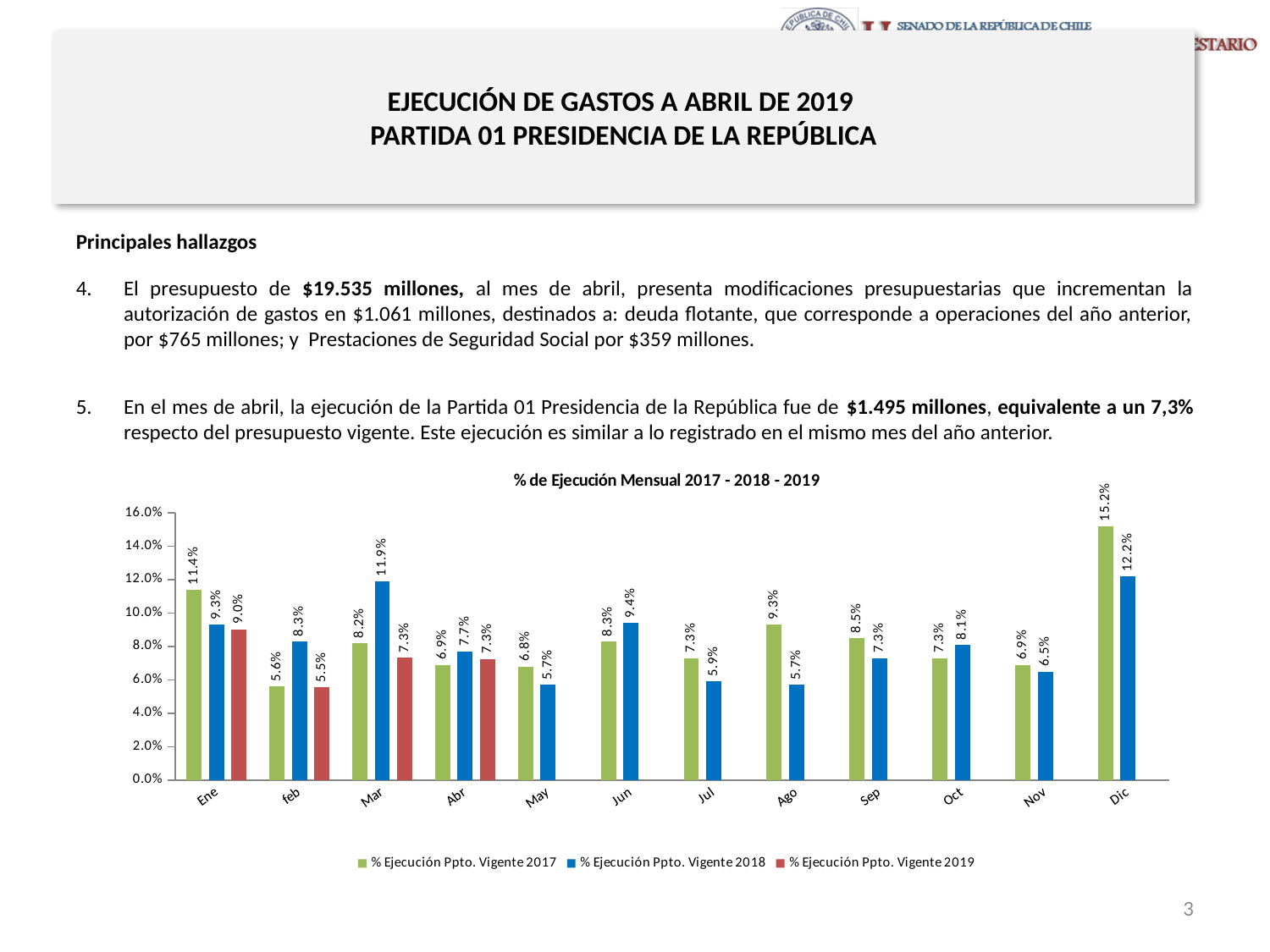
What is the value for % Ejecución Ppto. Vigente 2017 in Ago? 9.3% How many months are shown on the x axis? 12 What is the value for % Ejecución Ppto. Vigente 2019 in Ene? 9.0% What kind of chart is shown on the slide? Bar chart Is the value for % Ejecución Ppto. Vigente 2018 in Ene greater or less than 8.0%? greater Which month has the highest value for % Ejecución Ppto. Vigente 2017? Dic What is the title of the chart? % de Ejecución Mensual 2017 - 2018 - 2019 What is the difference between the 2017 and 2018 values in Dic? 3.0% Which month has the lowest value for % Ejecución Ppto. Vigente 2017? feb What is the value for % Ejecución Ppto. Vigente 2018 in Mar? 11.9% How many series does the legend list? 3 Which is larger in Abr: the 2018 value or the 2019 value? 2018 (7.7%)